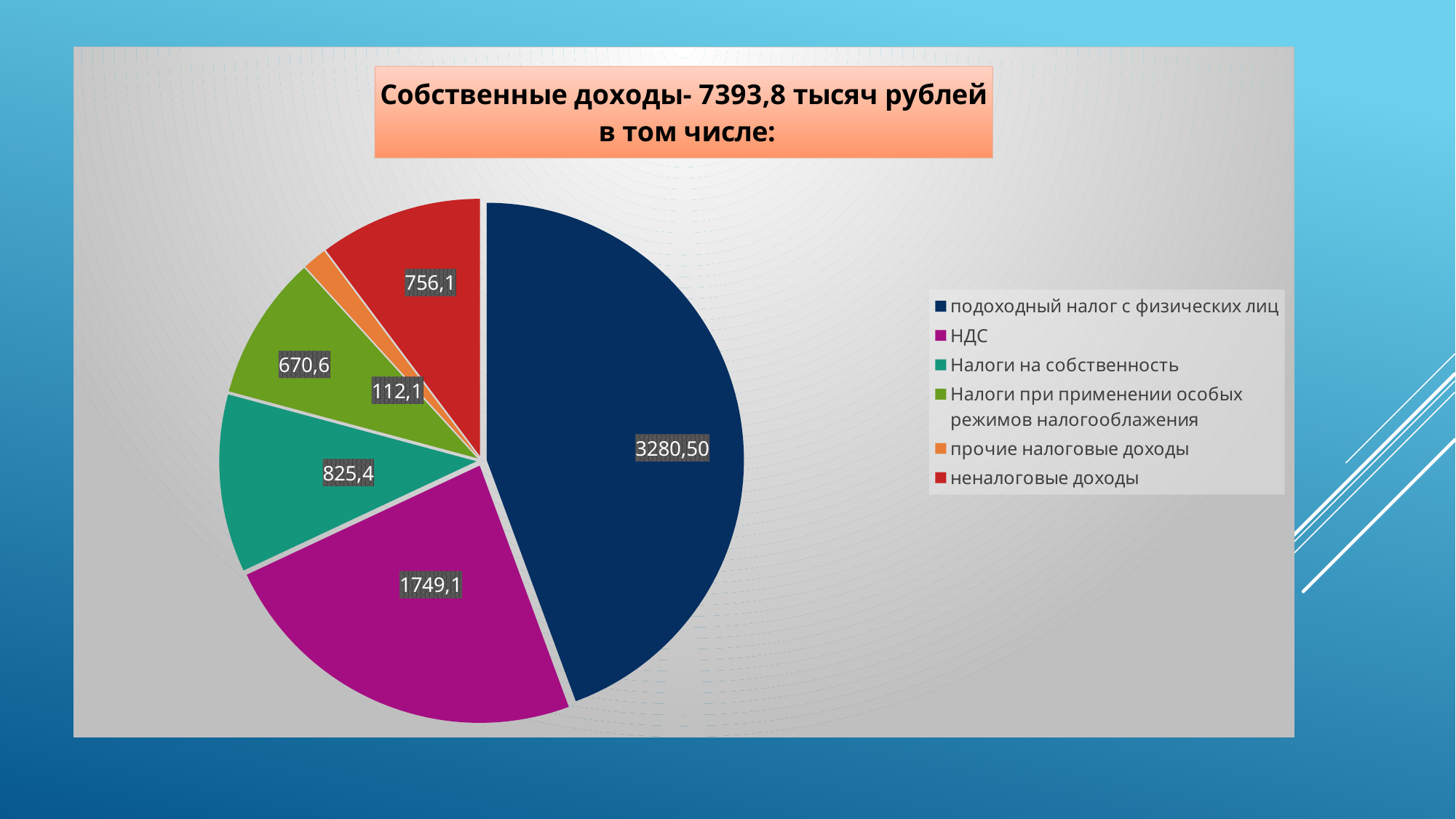
How many slices does the pie chart have? 6 What total amount of own revenues is stated in the chart title? 7393,8 тысяч рублей What is the difference between the values for подоходный налог с физических лиц and НДС? 1531,4 What kind of chart is shown on the slide? Pie chart What is the value for НДС? 1749,1 What is the value for подоходный налог с физических лиц? 3280,50 Which category has the smallest slice of the pie? прочие налоговые доходы Which category has the largest slice of the pie? подоходный налог с физических лиц What is the value for прочие налоговые доходы? 112,1 What colour is the slice for НДС? Magenta (purple) What is the value for Налоги на собственность? 825,4 Which is larger: неналоговые доходы or Налоги при применении особых режимов налогооблажения? неналоговые доходы